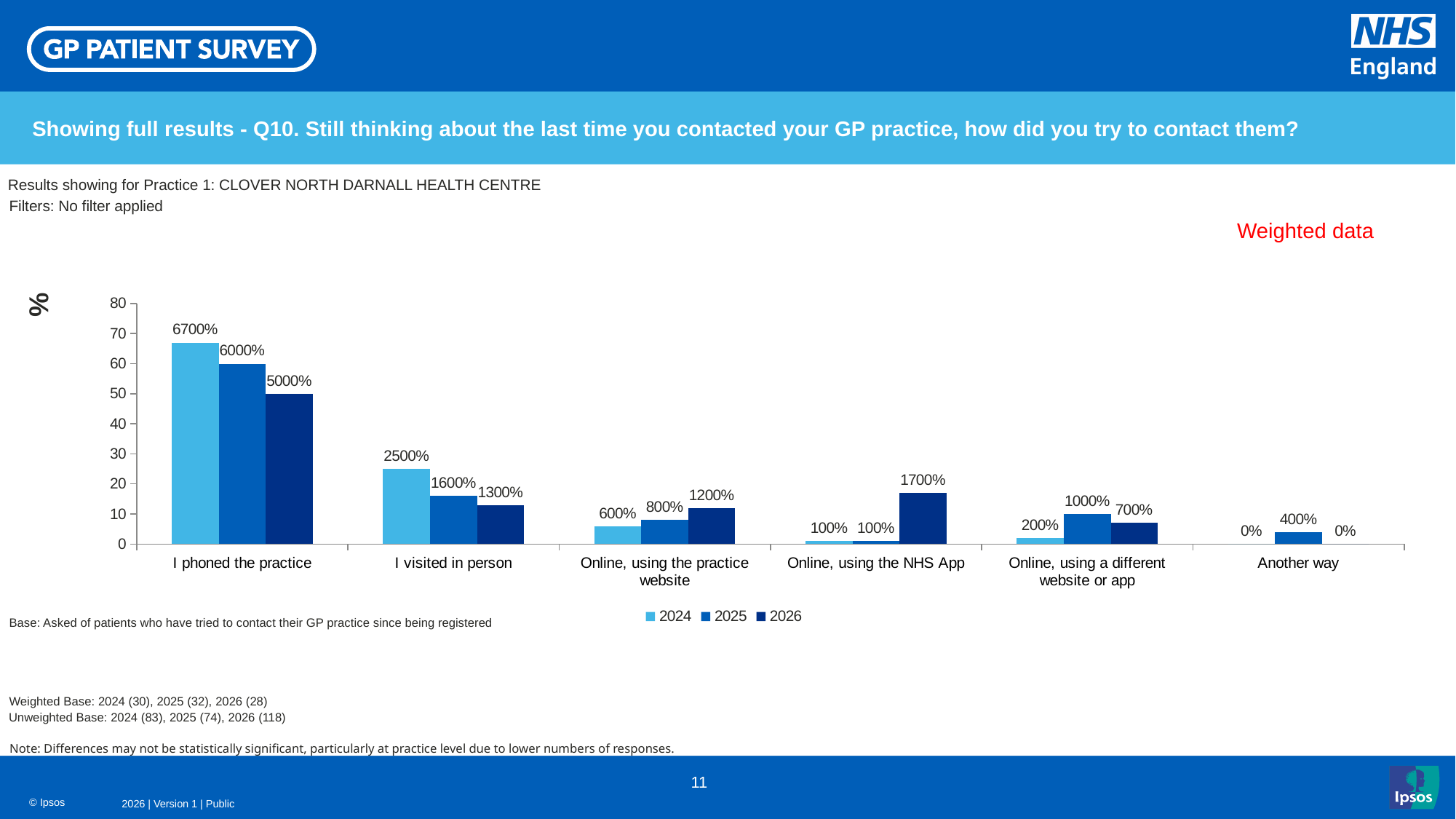
How many categories are shown on the x axis? 6 What is the 2026 value for 'Online, using the NHS App'? 1700% Which category has the lowest 2024 value? Another way What is the difference between the 2024 and 2026 values for 'I phoned the practice'? 1700% What is the 2024 value for 'I phoned the practice'? 6700% What is the difference between the 2025 and 2026 values for 'Online, using the practice website'? 400% Which is larger for 'Online, using a different website or app': the 2025 value or the 2026 value? 2025 Which category has the highest 2026 value? I phoned the practice How many series does the legend list? 3 What is the 2025 value for 'Another way'? 400% Do the values for 'I visited in person' rise or fall from 2024 to 2026? Fall What kind of chart is shown on the slide? Bar chart